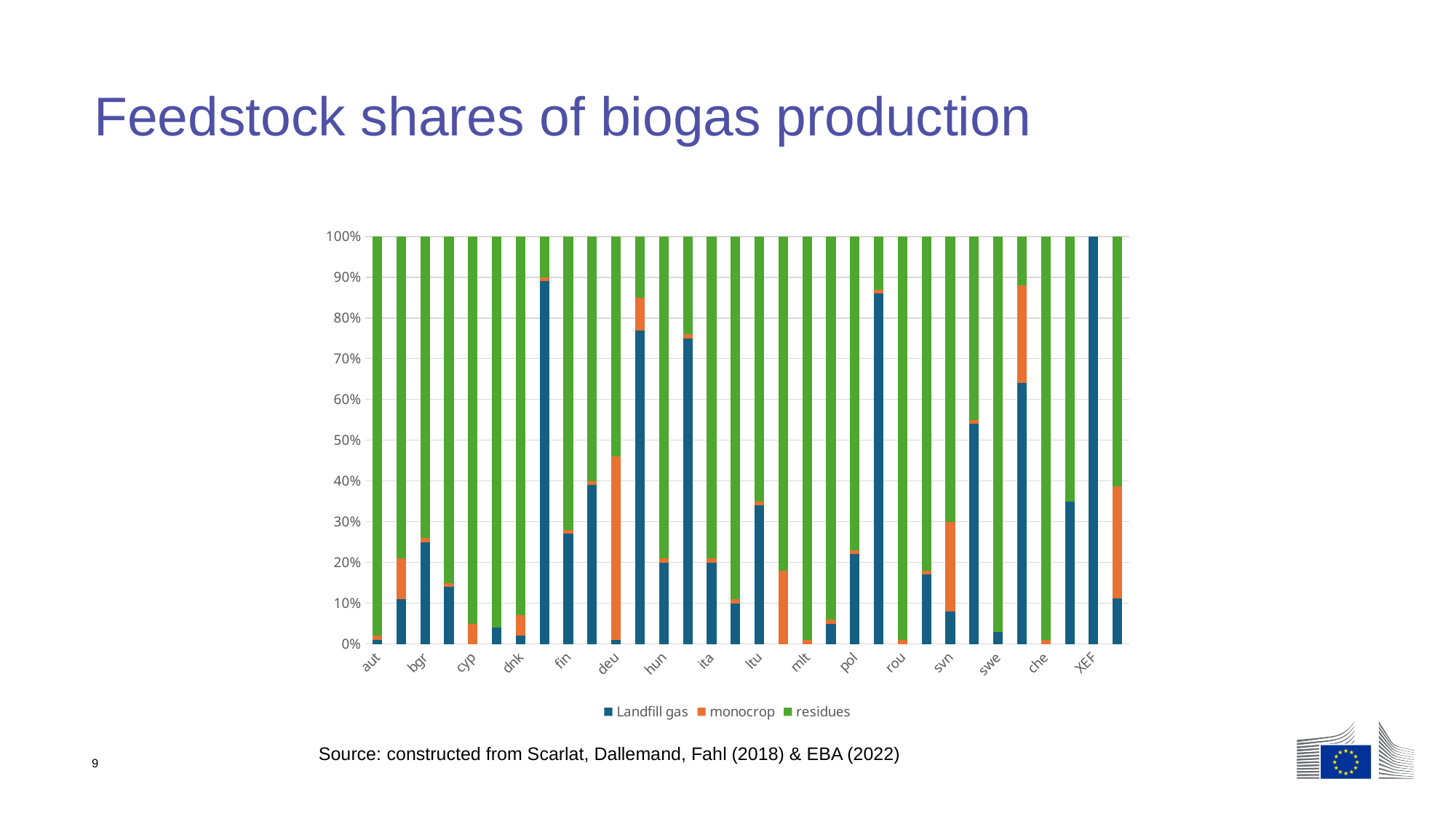
Is the Landfill gas share for hun greater or less than 30%? less Is the monocrop share for deu greater or less than 30%? greater Is the Landfill gas share for bgr greater or less than 20%? greater Which series is shown in green in the chart? residues What is the title of the chart on the slide? Feedstock shares of biogas production What is the Landfill gas share for XEF? 100% Which has the larger monocrop share, deu or mlt? deu How many series does the legend list? 3 What kind of chart is shown on the slide? Stacked bar chart Which has the larger Landfill gas share, fin or swe? fin